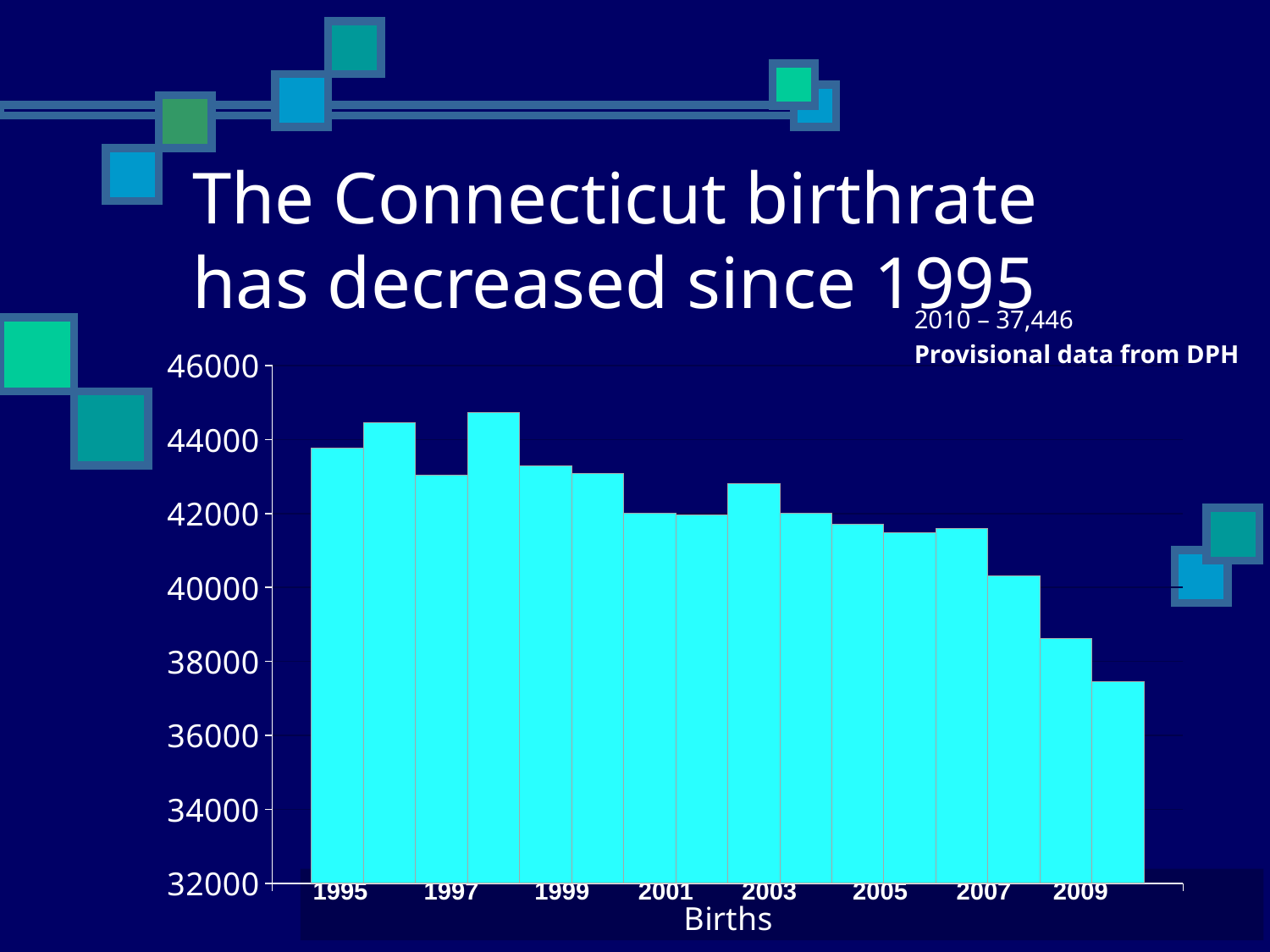
What is the title of the slide containing the chart? The Connecticut birthrate has decreased since 1995 What kind of chart is shown on the slide? bar chart What is the number of births for 2010 as stated on the slide? 37,446 Do the births generally rise or fall from 1995 to 2010? fall Is the value for 2009 greater or less than 40000? less Is the value for 1995 greater or less than 42000? greater Is the value for 2010 greater or less than 38000? less Which year has the highest number of births in the chart? 1998 Which year has the lowest number of births in the chart? 2010 How many bars (years) are plotted in the chart? 16 What label appears below the x axis of the chart? Births Which year has more births, 1995 or 2009? 1995